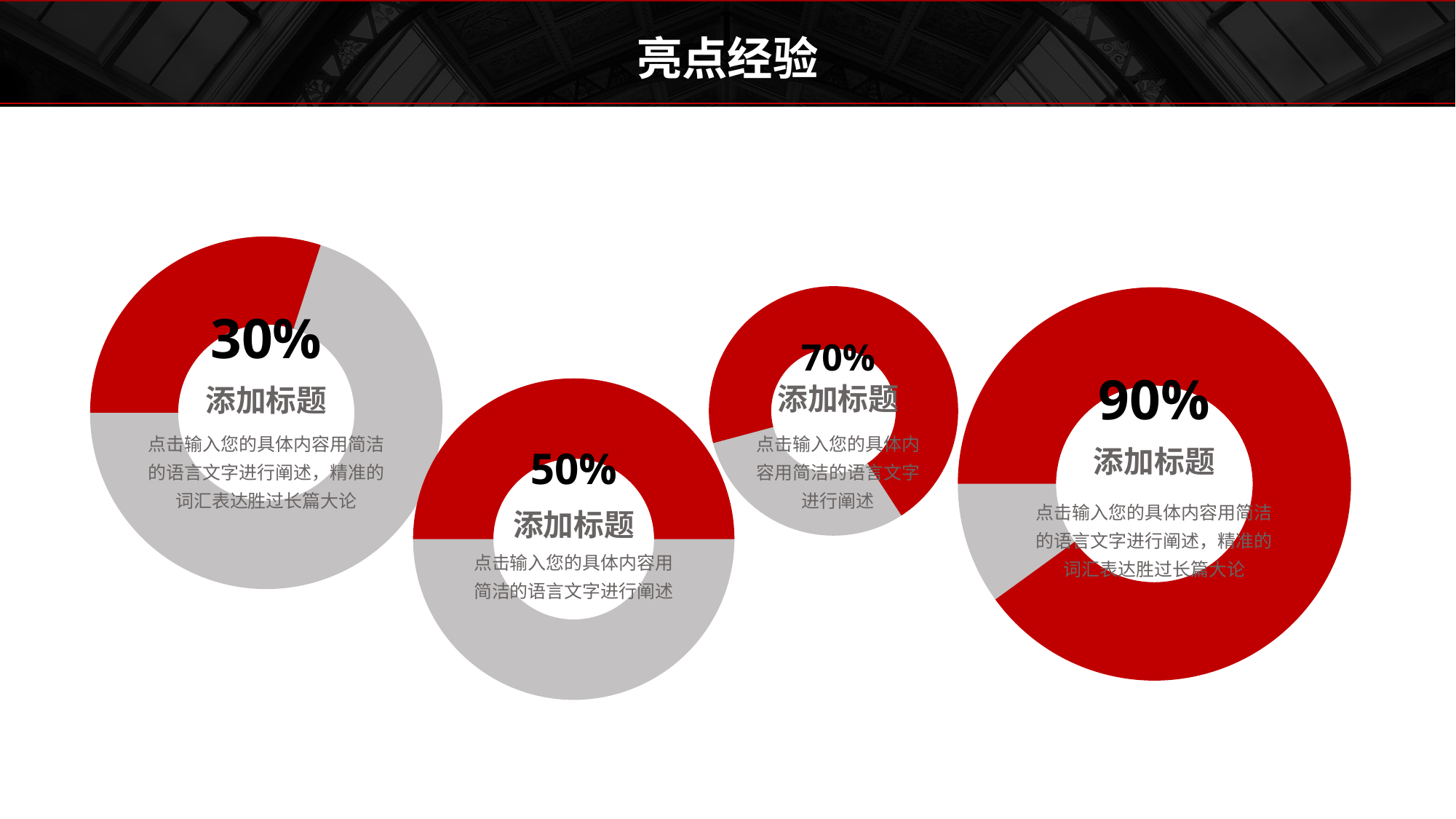
Do the percentages in the donut charts rise or fall from left to right across the slide? Rise What colour is the filled portion of each donut chart that represents the percentage? Red What percentage is shown in the centre of the second donut chart from the left? 50% Which donut chart shows the lowest percentage? The leftmost chart (30%) Which is larger, the percentage in the second donut chart from the left or the percentage in the third donut chart from the left? The third chart (70%) What is the difference between the percentage in the rightmost donut chart and the percentage in the leftmost donut chart? 60% Which donut chart shows the highest percentage? The rightmost chart (90%) What percentage is shown in the centre of the leftmost donut chart? 30% What percentage is shown in the centre of the third donut chart from the left? 70% What percentage is shown in the centre of the rightmost donut chart? 90% What kind of chart is the leftmost chart on the slide? Donut chart How many donut charts are on the slide? 4